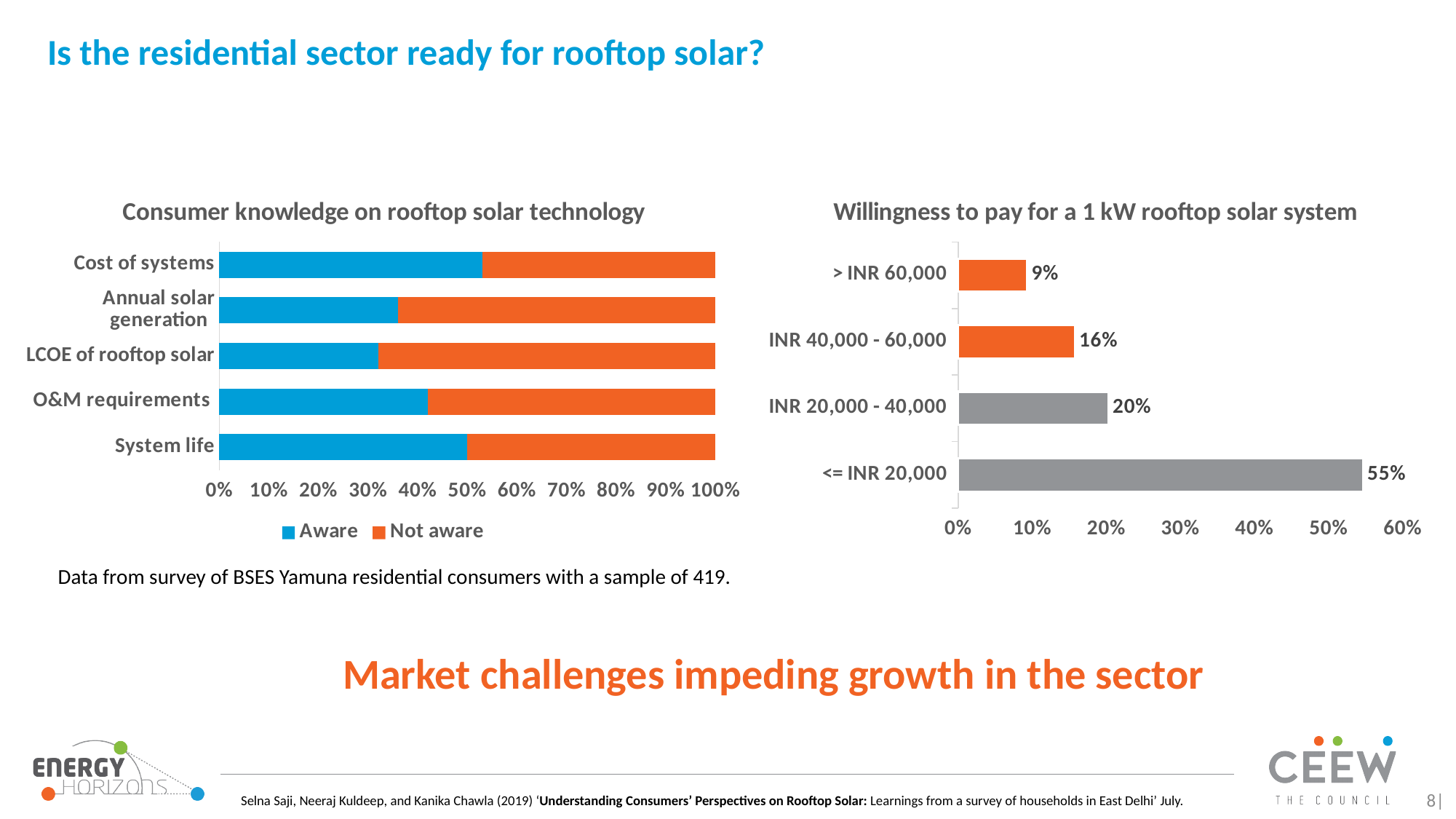
In the 'Consumer knowledge on rooftop solar technology' chart, is the 'Aware' share for Cost of systems greater or less than 50%? greater In the 'Willingness to pay for a 1 kW rooftop solar system' chart, what is the value for > INR 60,000? 9% In the 'Willingness to pay for a 1 kW rooftop solar system' chart, what is the value for INR 40,000 - 60,000? 16% In the 'Willingness to pay for a 1 kW rooftop solar system' chart, what percentage of consumers are willing to pay <= INR 20,000? 55% In the 'Willingness to pay for a 1 kW rooftop solar system' chart, how many price ranges are shown? 4 In the 'Consumer knowledge on rooftop solar technology' chart, is the 'Aware' share for LCOE of rooftop solar greater or less than 40%? less In the 'Consumer knowledge on rooftop solar technology' chart, which has a larger 'Aware' share: Cost of systems or LCOE of rooftop solar? Cost of systems In the 'Consumer knowledge on rooftop solar technology' chart, how many series does the legend list? 2 In the 'Willingness to pay for a 1 kW rooftop solar system' chart, which price range has the lowest share? > INR 60,000 What kind of chart is 'Consumer knowledge on rooftop solar technology'? Stacked bar chart In the 'Willingness to pay for a 1 kW rooftop solar system' chart, which price range has the highest share? <= INR 20,000 In the 'Willingness to pay for a 1 kW rooftop solar system' chart, what is the difference between the values for <= INR 20,000 and > INR 60,000? 46%